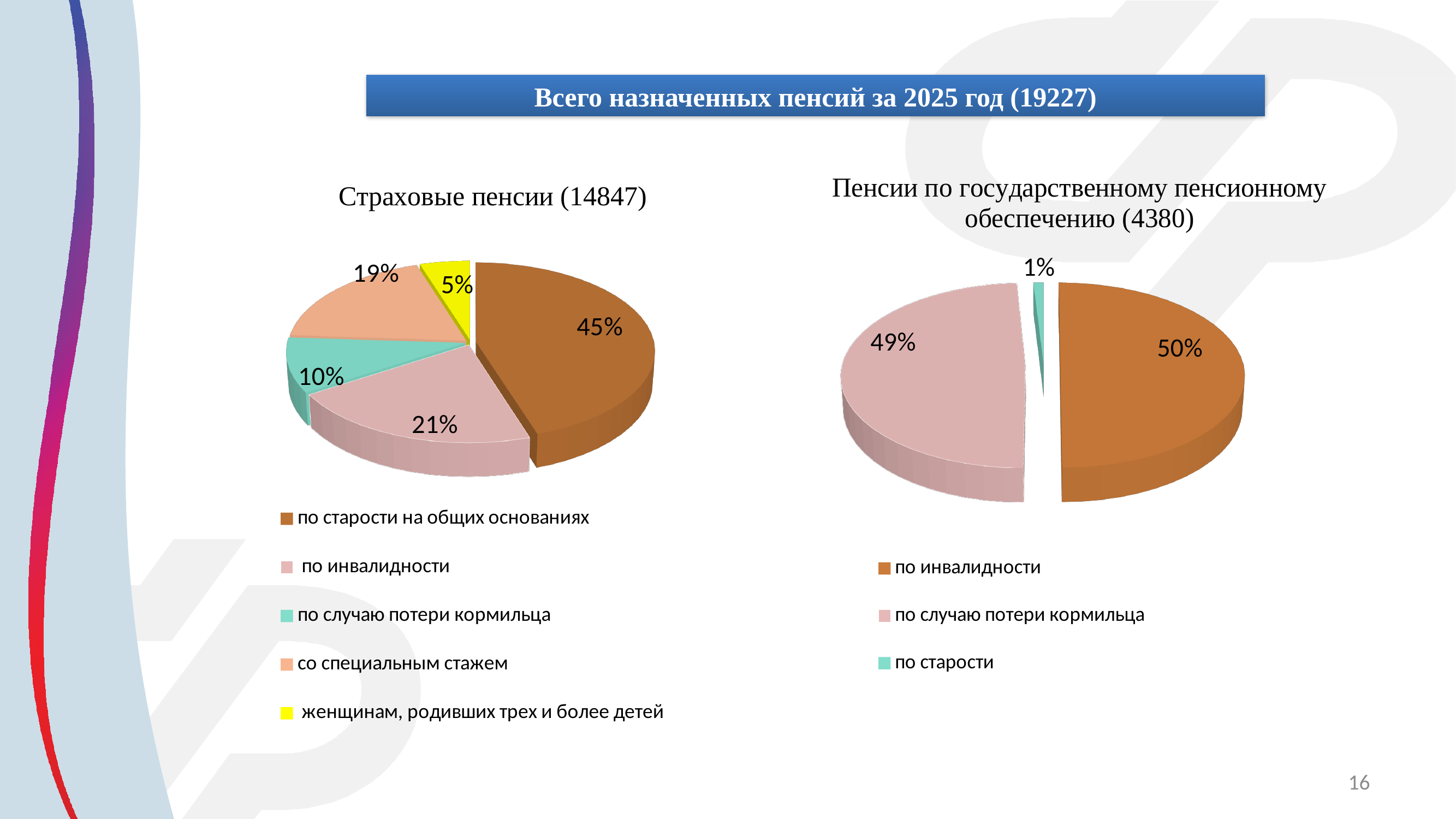
In the chart titled 'Пенсии по государственному пенсионному обеспечению (4380)', which is larger, 'по инвалидности' or 'по случаю потери кормильца'? по инвалидности In the chart titled 'Пенсии по государственному пенсионному обеспечению (4380)', which category has the smallest slice? по старости In the chart titled 'Страховые пенсии (14847)', what percentage is shown for 'по инвалидности'? 21% In the chart titled 'Страховые пенсии (14847)', how many categories are shown? 5 In the chart titled 'Страховые пенсии (14847)', which category has the smallest slice? женщинам, родивших трех и более детей What type of chart is the chart titled 'Страховые пенсии (14847)'? Pie chart In the chart titled 'Страховые пенсии (14847)', what share of the pie is 'по старости на общих основаниях'? 45% In the chart titled 'Страховые пенсии (14847)', what percentage is shown for 'со специальным стажем'? 19% In the chart titled 'Пенсии по государственному пенсионному обеспечению (4380)', how many categories does the legend list? 3 In the chart titled 'Пенсии по государственному пенсионному обеспечению (4380)', what percentage is shown for 'по старости'? 1% In the chart titled 'Страховые пенсии (14847)', which category has the largest slice? по старости на общих основаниях In the chart titled 'Страховые пенсии (14847)', what is the difference in percentage points between 'по инвалидности' and 'по случаю потери кормильца'? 11